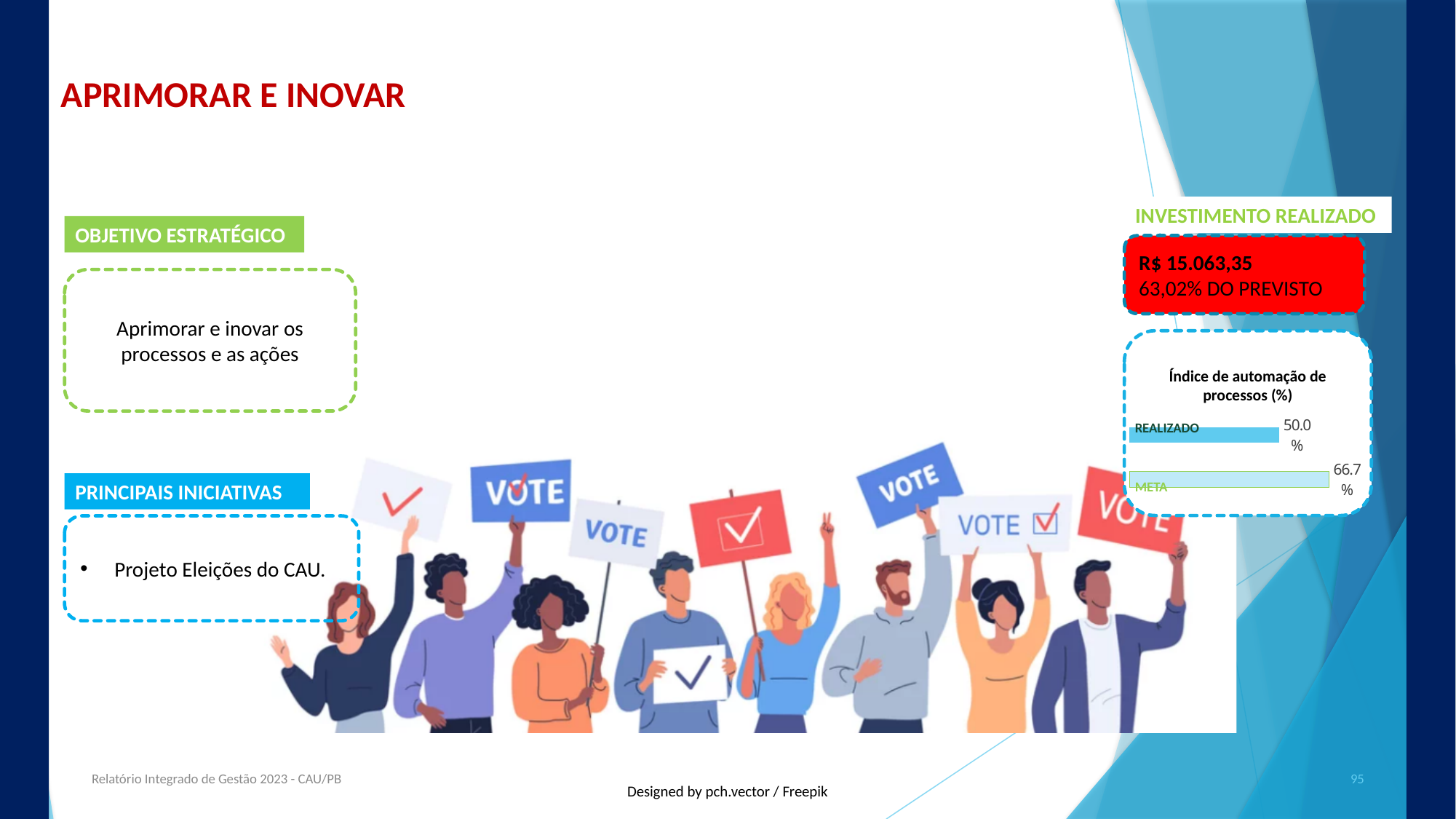
How many bars are plotted in the chart "Índice de automação de processos (%)"? 2 In the chart "Índice de automação de processos (%)", is the value for REALIZADO larger or smaller than the value for META? smaller In the chart "Índice de automação de processos (%)", what is the difference between META and REALIZADO? 16.7% In the chart "Índice de automação de processos (%)", what is the value for META? 66.7% In the chart "Índice de automação de processos (%)", which category has the higher value? META What is the title of the chart on the slide? Índice de automação de processos (%) What are the two category labels in the chart "Índice de automação de processos (%)"? REALIZADO and META What kind of chart is shown under "Índice de automação de processos (%)"? bar chart In the chart "Índice de automação de processos (%)", which category has the lower value? REALIZADO In the chart "Índice de automação de processos (%)", what is the value for REALIZADO? 50.0%